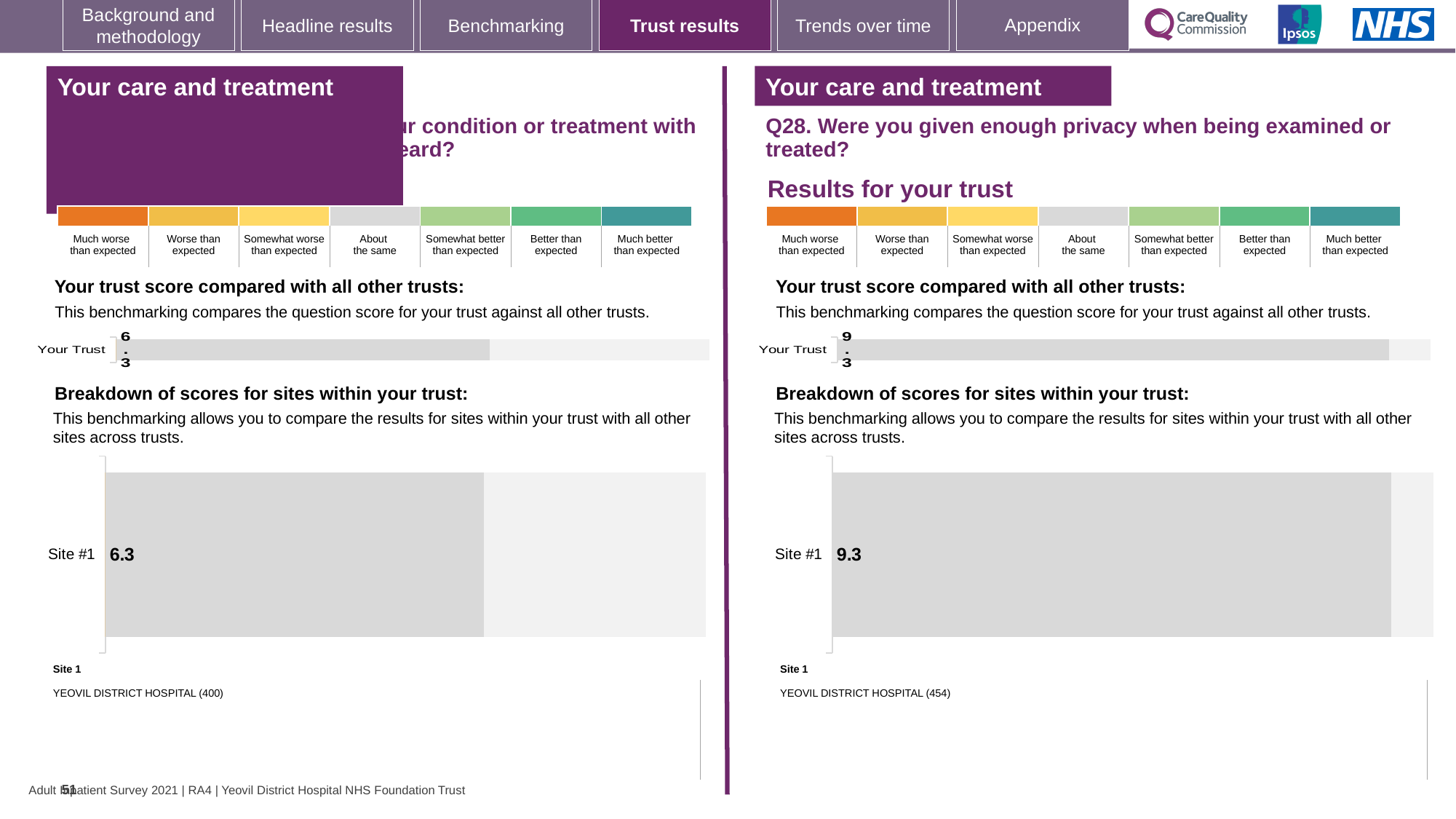
In the left-hand 'Breakdown of scores for sites within your trust' chart, what is the score for Site #1? 6.3 How many sites are shown in the right-hand 'Breakdown of scores for sites within your trust' chart for Q28? 1 Which is larger: the Your Trust score on the left-hand side of the slide or the Your Trust score on the right-hand side (Q28)? Right-hand side (Q28) On the left-hand side of the slide, what is the score shown for Your Trust in the 'Your trust score compared with all other trusts' chart? 6.3 How many sites are shown in the left-hand 'Breakdown of scores for sites within your trust' chart? 1 In the left-hand breakdown chart, which site name is listed as Site 1? YEOVIL DISTRICT HOSPITAL (400) On the right-hand side of the slide (Q28), what is the score shown for Your Trust in the 'Your trust score compared with all other trusts' chart? 9.3 In the right-hand breakdown chart for Q28, which site name is listed as Site 1? YEOVIL DISTRICT HOSPITAL (454) What is the difference between the Site #1 score in the right-hand (Q28) breakdown chart and the Site #1 score in the left-hand breakdown chart? 3.0 What type of chart is used to show the Site #1 score in the right-hand breakdown chart for Q28? Bar chart In the right-hand 'Breakdown of scores for sites within your trust' chart for Q28, what is the score for Site #1? 9.3